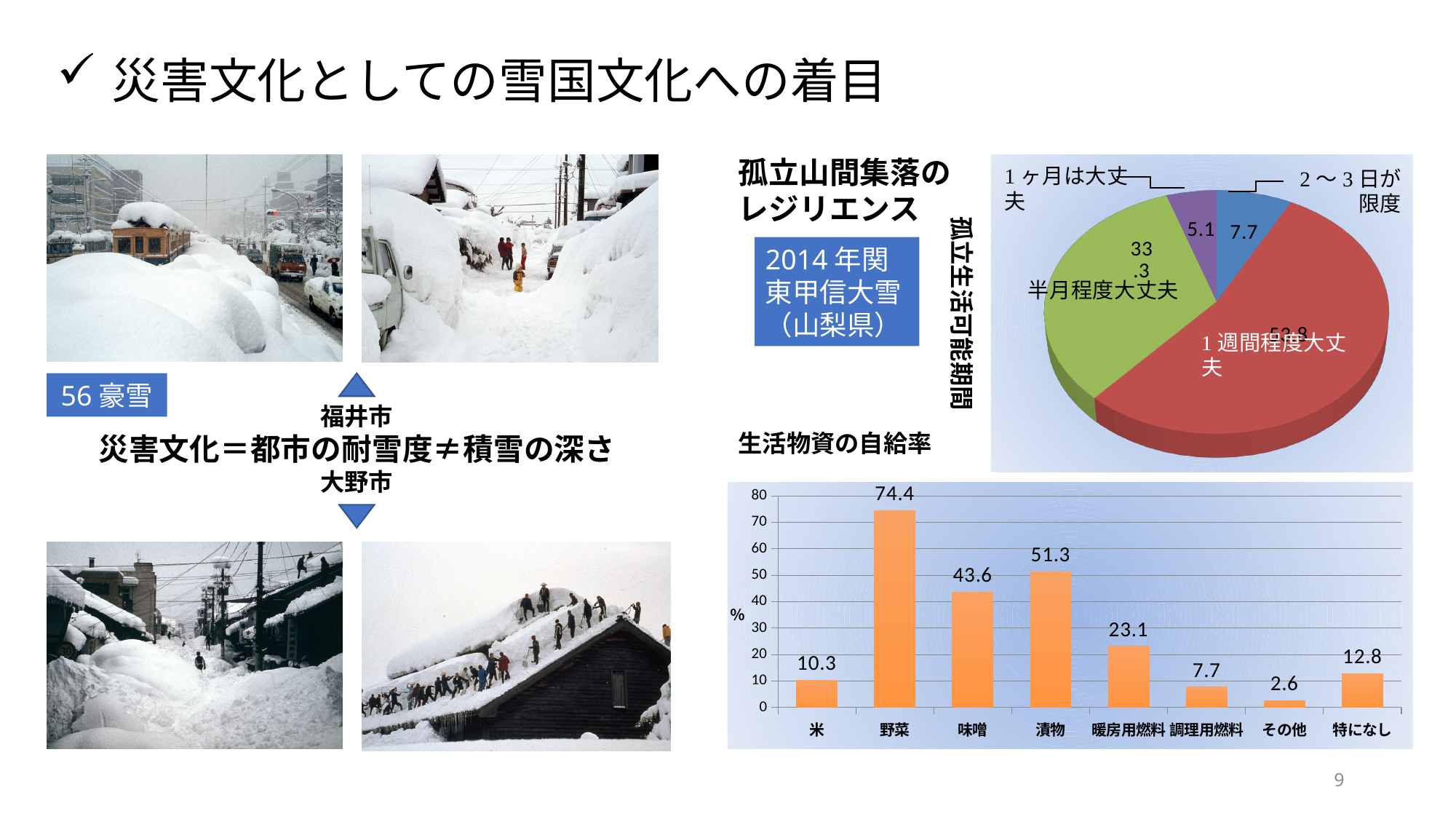
What kind of chart is the chart titled 生活物資の自給率? bar chart In the bar chart titled 生活物資の自給率, how many categories are shown on the x axis? 8 In the bar chart titled 生活物資の自給率, which category has the highest value? 野菜 In the bar chart titled 生活物資の自給率, what is the value for 野菜? 74.4 In the bar chart titled 生活物資の自給率, which category has the lowest value? その他 In the bar chart titled 生活物資の自給率, what is the difference between the values for 漬物 and 味噌? 7.7 In the bar chart titled 生活物資の自給率, what is the value for 暖房用燃料? 23.1 In the pie chart on the right (孤立生活可能期間), what is the value for the slice labelled 半月程度大丈夫? 33.3 In the pie chart on the right (孤立生活可能期間), which slice is the smallest? 1ヶ月は大丈夫 In the pie chart on the right (孤立生活可能期間), what is the value for the slice labelled 2～3日が限度? 7.7 In the pie chart on the right (孤立生活可能期間), which slice is the largest? 1週間程度大丈夫 In the bar chart titled 生活物資の自給率, which is larger, the value for 米 or the value for 特になし? 特になし